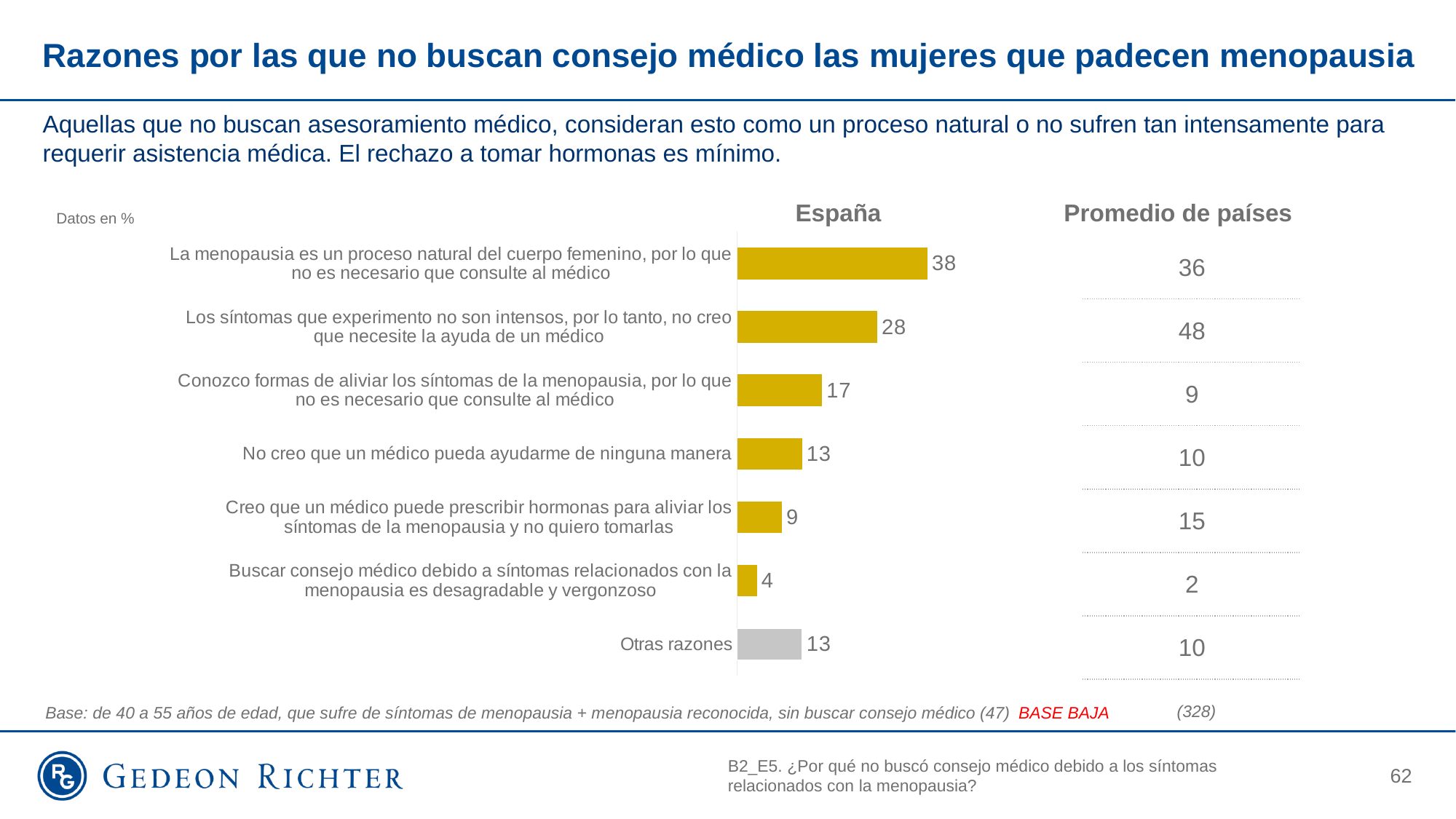
What is the difference between the España value and the Promedio de países value for 'Los síntomas que experimento no son intensos, por lo tanto, no creo que necesite la ayuda de un médico'? 20 What is the difference between the España values for 'Conozco formas de aliviar los síntomas de la menopausia' and 'Creo que un médico puede prescribir hormonas para aliviar los síntomas de la menopausia y no quiero tomarlas'? 8 What is the España value for 'No creo que un médico pueda ayudarme de ninguna manera'? 13 Which reason has the lowest España value? Buscar consejo médico debido a síntomas relacionados con la menopausia es desagradable y vergonzoso What is the España value for 'La menopausia es un proceso natural del cuerpo femenino, por lo que no es necesario que consulte al médico'? 38 What is the Promedio de países value for 'Los síntomas que experimento no son intensos, por lo tanto, no creo que necesite la ayuda de un médico'? 48 Which reason has the highest España value? La menopausia es un proceso natural del cuerpo femenino, por lo que no es necesario que consulte al médico For 'Conozco formas de aliviar los síntomas de la menopausia, por lo que no es necesario que consulte al médico', which is larger: the España value or the Promedio de países value? España How many reasons (categories) are shown in the chart? 7 What type of chart is used to show the España values? Bar chart What is the Promedio de países value for 'Buscar consejo médico debido a síntomas relacionados con la menopausia es desagradable y vergonzoso'? 2 Which bar is shown in grey rather than yellow? Otras razones